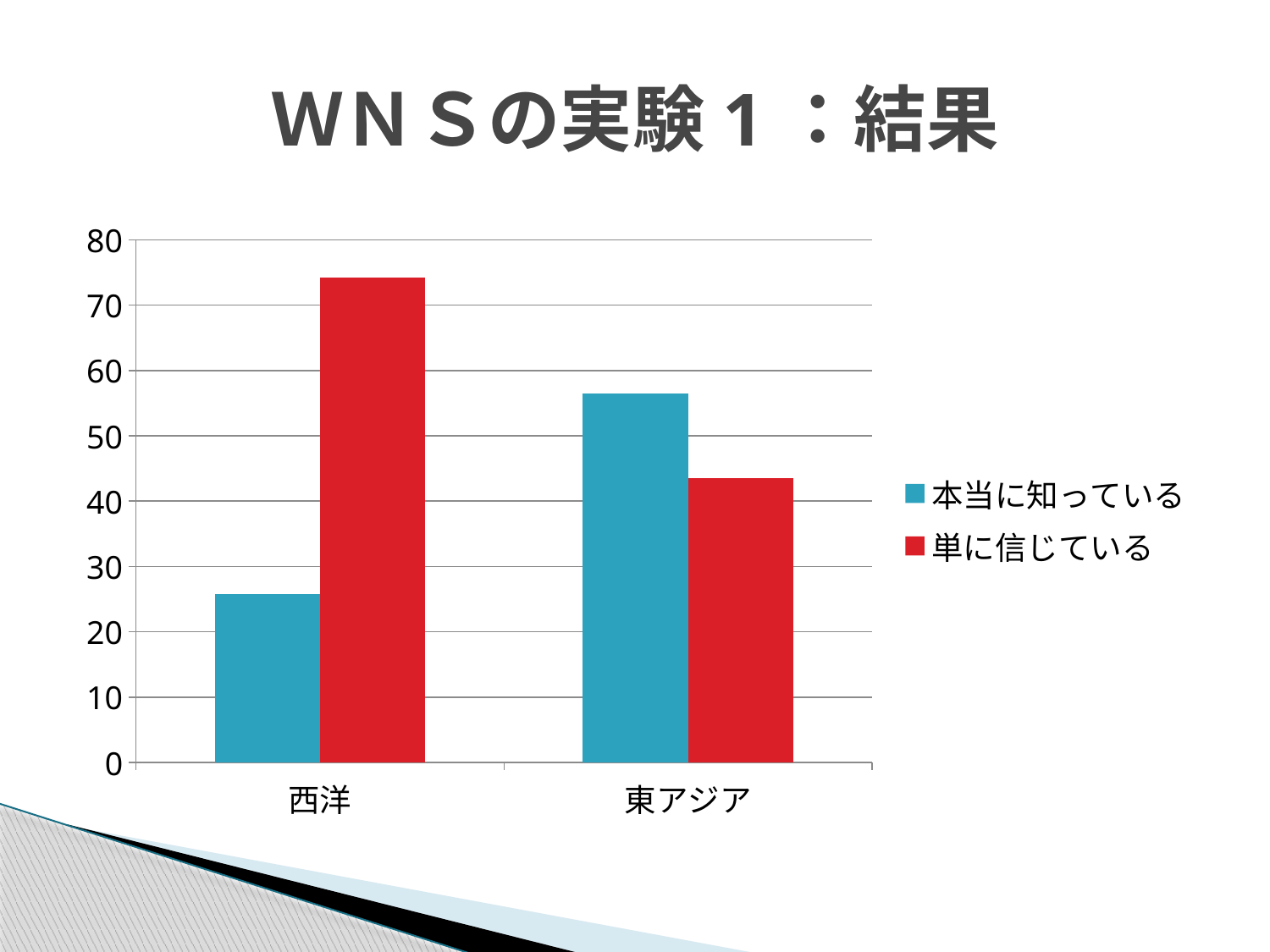
What kind of chart is shown on the slide? bar chart Is the value for 本当に知っている in 東アジア greater or less than 50? greater Which series has the larger value for 西洋? 単に信じている How many categories are shown on the x axis of the chart? 2 Which bar in the chart is the lowest? 本当に知っている for 西洋 Which bar in the chart is the highest? 単に信じている for 西洋 Is the value for 単に信じている in 東アジア greater or less than 50? less What is the title of the slide? WNSの実験1：結果 Is the value for 本当に知っている in 西洋 greater or less than 30? less Which series has the larger value for 東アジア? 本当に知っている How many series does the legend list? 2